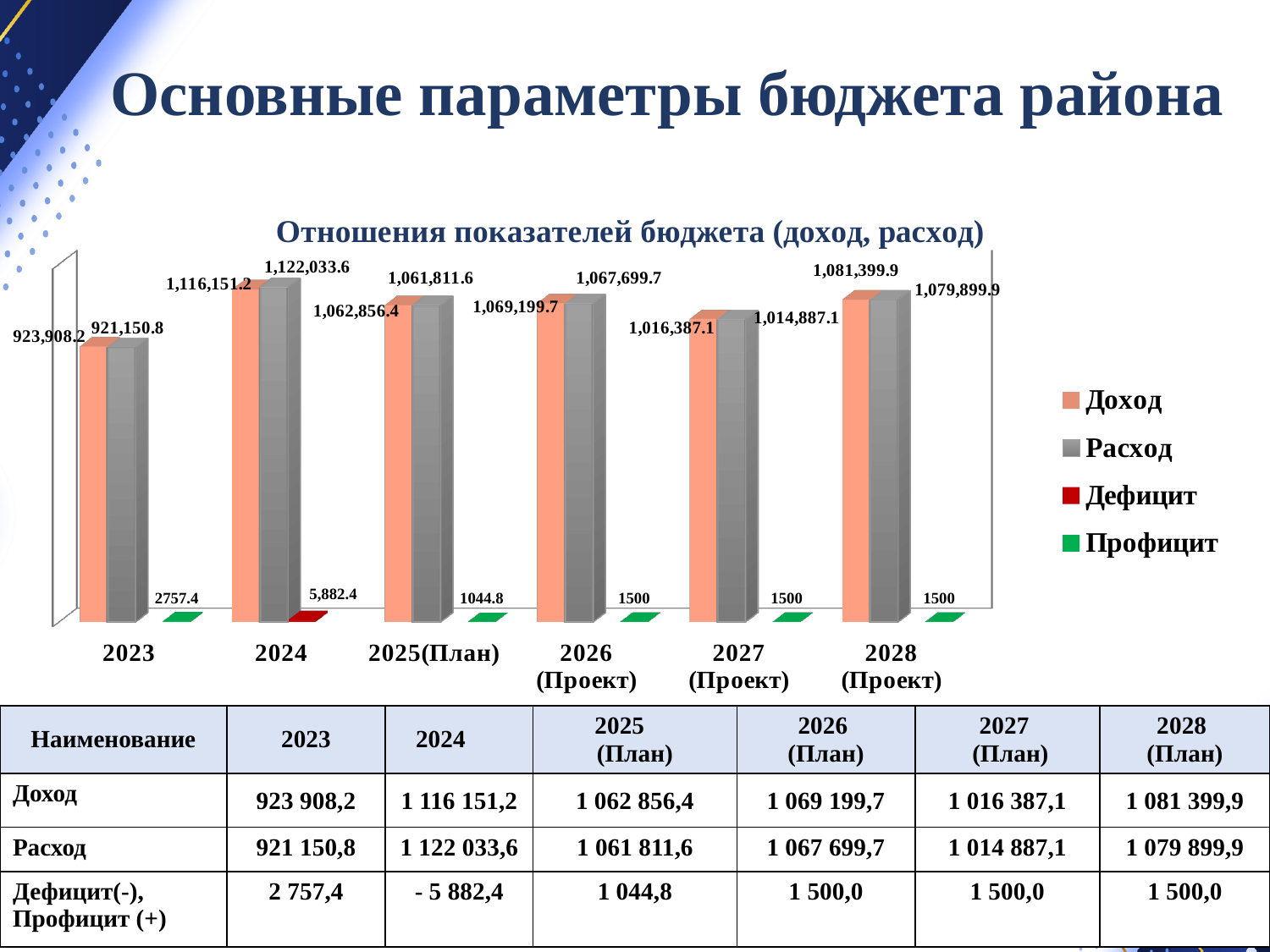
How many series does the chart legend list? 4 What is the value of Расход for 2024 in the chart? 1,122,033.6 What is the value of Доход for 2028 (Проект) in the chart? 1,081,399.9 What is the value of Доход for 2023 in the chart? 923,908.2 How many years (categories) are shown on the x axis of the chart? 6 What is the difference between Доход and Расход for 2023 in the chart? 2757.4 Does the Доход value rise or fall from 2023 to 2024 in the chart? Rise Which year has the highest Доход value in the chart? 2024 What type of chart is shown on the slide? Bar chart For 2024, which is larger in the chart: Доход or Расход? Расход Which year has the lowest Расход value in the chart? 2023 What is the title of the chart on the slide? Отношения показателей бюджета (доход, расход)